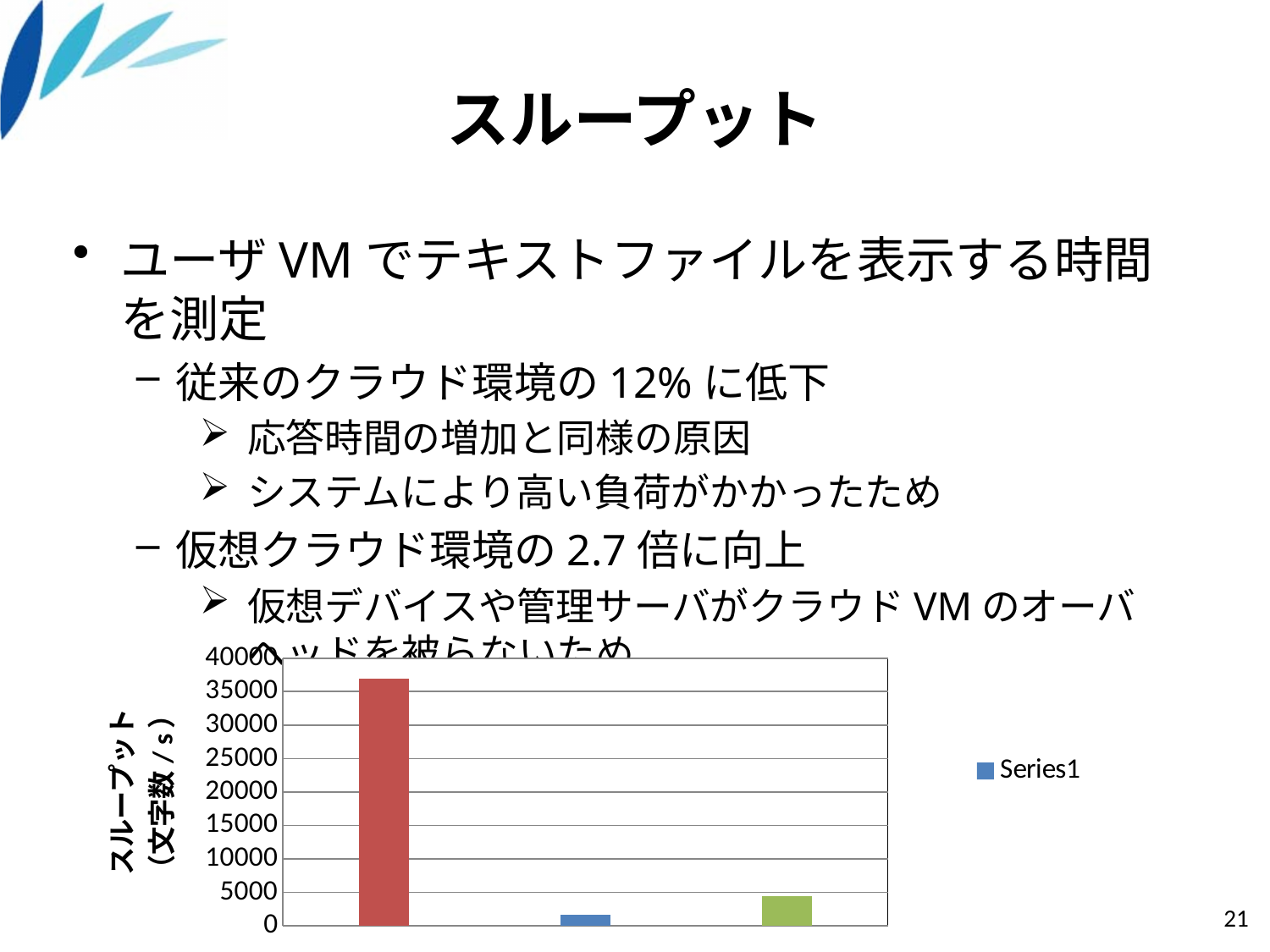
Which is larger, the first (red) bar or the third (green) bar? the first (red) bar Is the value of the second (blue) bar greater or less than 5000? less What is the legend entry shown next to the chart? Series1 How many bars are plotted in the chart? 3 Is the value of the first (red) bar greater or less than 35000? greater Which bar is the shortest in the chart: the first (red), second (blue), or third (green)? the second (blue) bar Which bar is the tallest in the chart: the first (red), second (blue), or third (green)? the first (red) bar Which is larger, the third (green) bar or the second (blue) bar? the third (green) bar Is the value of the third (green) bar greater or less than 10000? less What is the label on the vertical axis of the chart? スループット（文字数/s） What kind of chart is shown on the slide? bar chart How many series does the chart legend list? 1